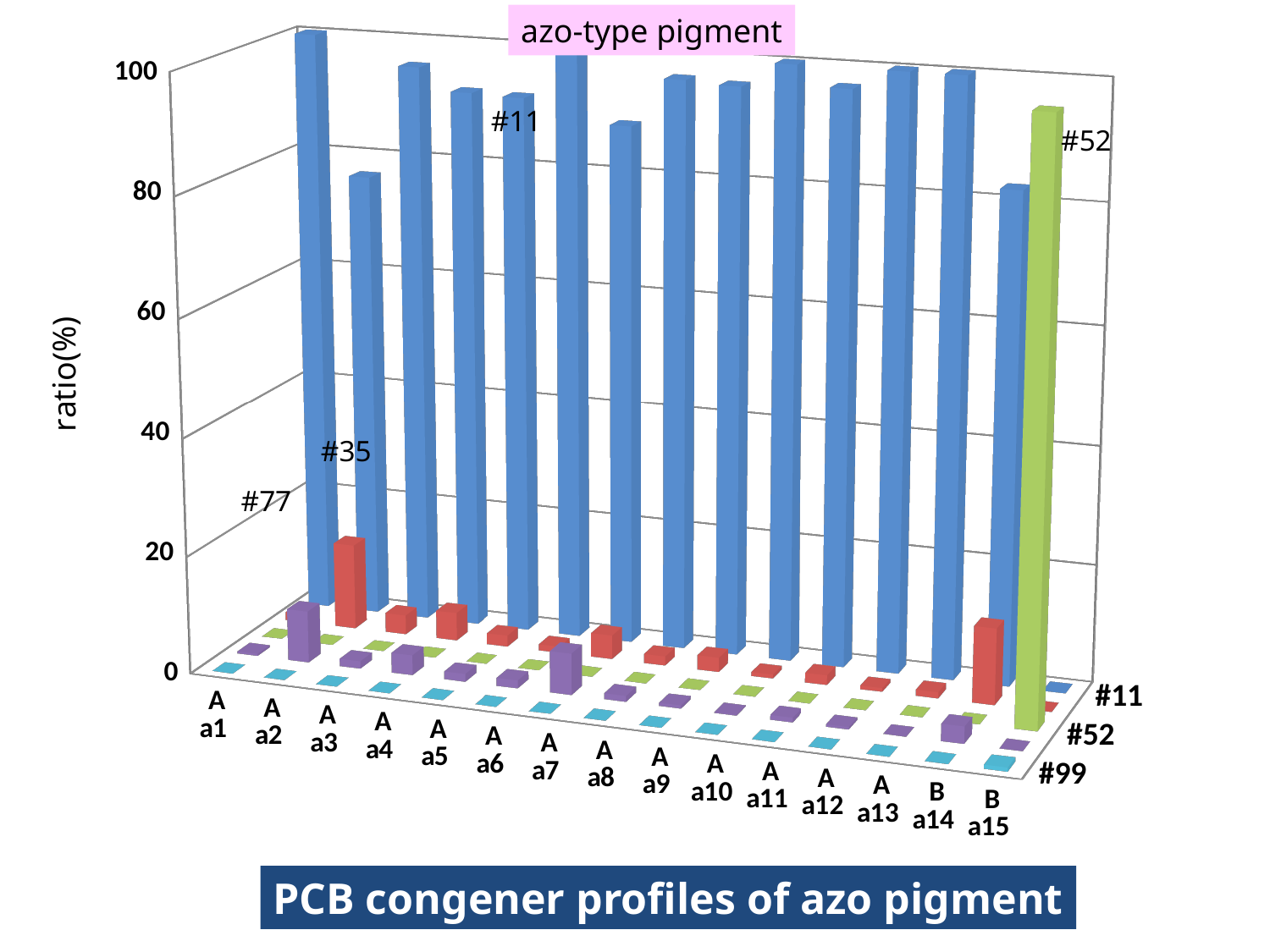
Which is larger for sample a15: the #11 value or the #52 value? #52 Is the #52 value for sample a15 greater or less than 60? greater Is the #11 value for sample a8 greater or less than 60? greater What kind of chart is shown on the slide? bar chart Is the #11 value for sample a1 greater or less than 80? greater How many pigment samples (categories) are plotted along the x axis? 15 Which is larger for sample a1: the #11 value or the #99 value? #11 What is the title shown below the chart? PCB congener profiles of azo pigment What is the label on the vertical axis of the chart? ratio(%)